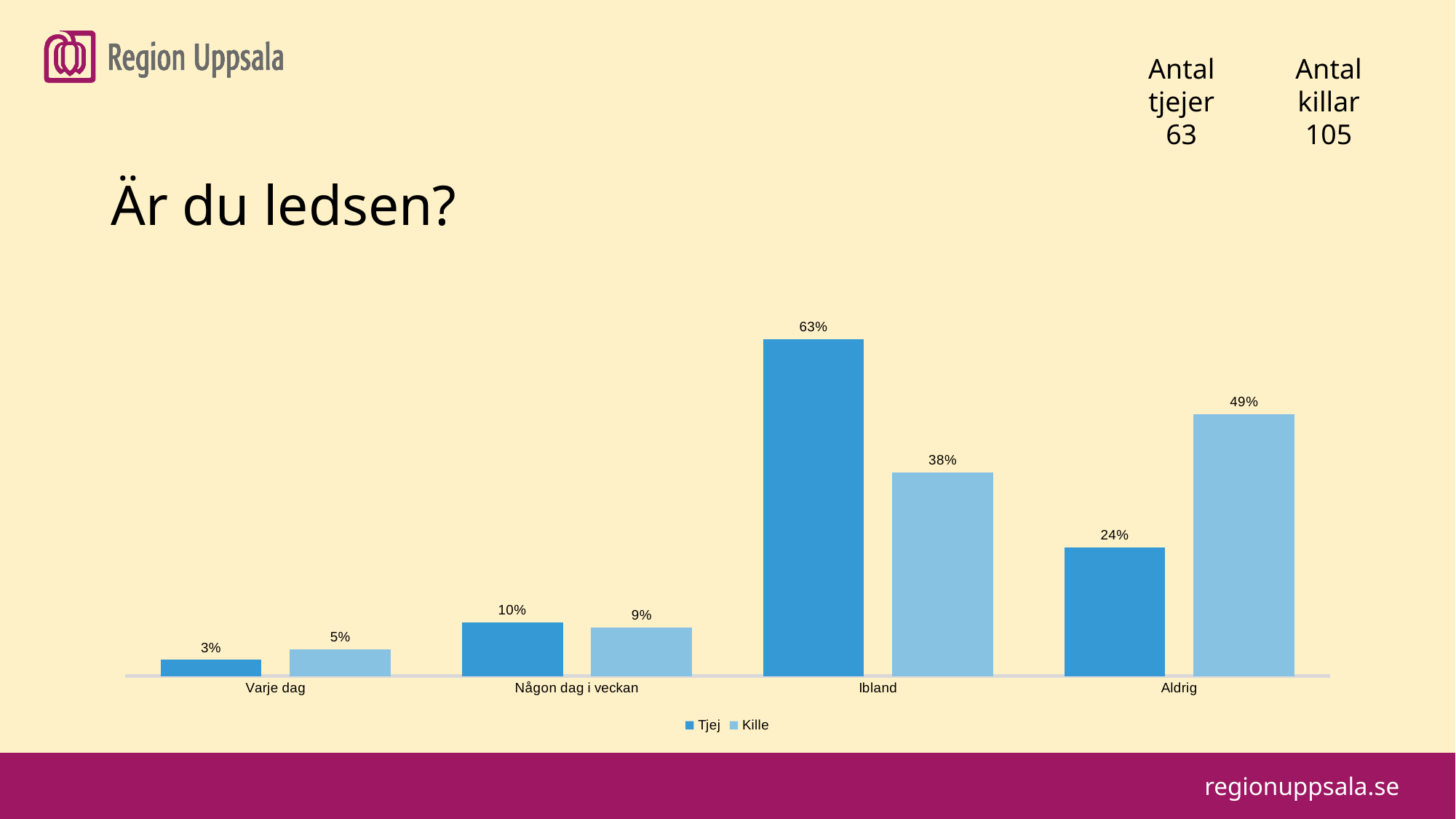
Which category has the lowest value for Kille? Varje dag What kind of chart is shown on the slide? Bar chart What is the value for Tjej in the Varje dag category? 3% What is the value for Tjej in the Ibland category? 63% What is the difference between the Tjej and Kille values in the Ibland category? 25% Which is larger in the Aldrig category, Tjej or Kille? Kille What is the title of the slide? Är du ledsen? What is the value for Kille in the Någon dag i veckan category? 9% Which category has the highest value for Tjej? Ibland How many categories are shown on the x axis? 4 How many series does the legend list? 2 What is the value for Kille in the Aldrig category? 49%